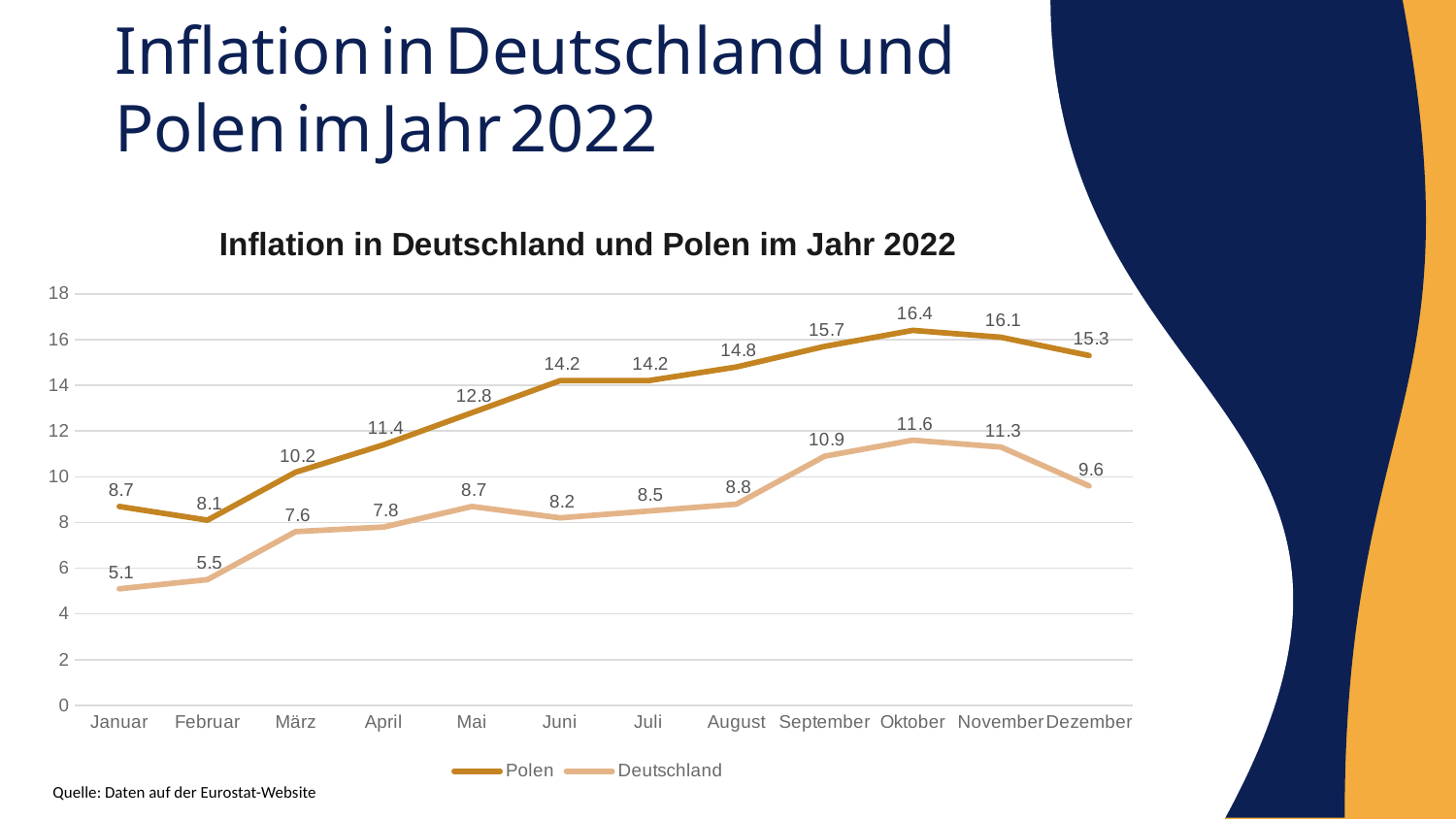
What is the inflation value for Deutschland in Januar? 5.1 What kind of chart is shown on the slide? Line chart What is the title of the chart? Inflation in Deutschland und Polen im Jahr 2022 What is the inflation value for Polen in Oktober? 16.4 What is the inflation value for Deutschland in Dezember? 9.6 Does the Polen series rise or fall from Januar to Oktober? Rise How many months are shown on the x axis? 12 What is the difference between the Polen and Deutschland values in Oktober? 4.8 Which series has the higher value in Juni, Polen or Deutschland? Polen How many series does the legend list? 2 In which month is the Deutschland series at its lowest? Januar In which month is the Polen series at its highest? Oktober